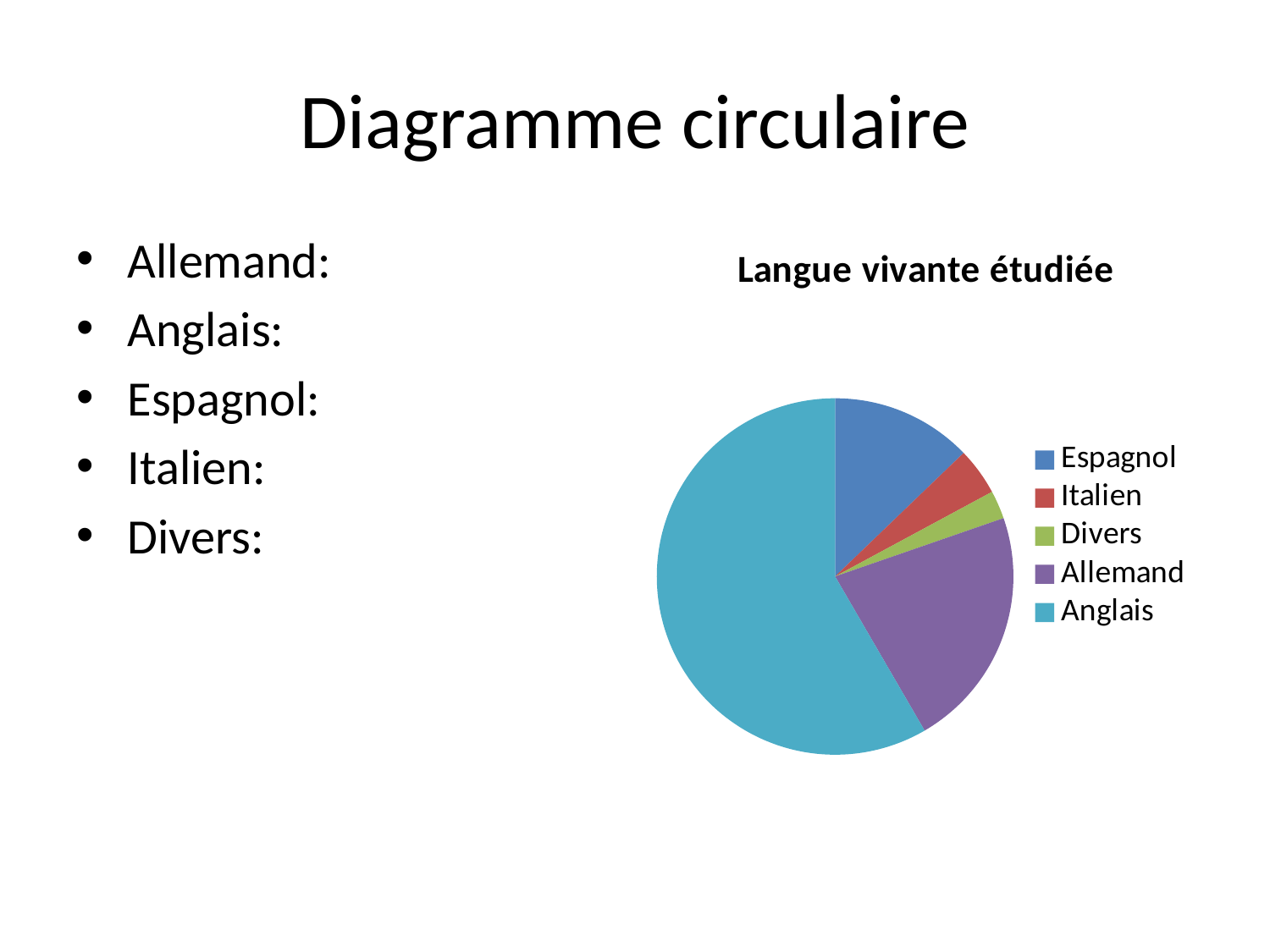
What is the title of the chart? Langue vivante étudiée How many slices does the pie chart have? 5 What kind of chart is shown on the slide? pie chart Which slice is larger, Allemand or Divers? Allemand Which slice is larger, Anglais or Allemand? Anglais Which slice is larger, Allemand or Espagnol? Allemand How many entries does the chart legend list? 5 Which language has the smallest slice of the pie? Divers Which legend entry is listed first in the chart legend? Espagnol Which language has the largest slice of the pie? Anglais